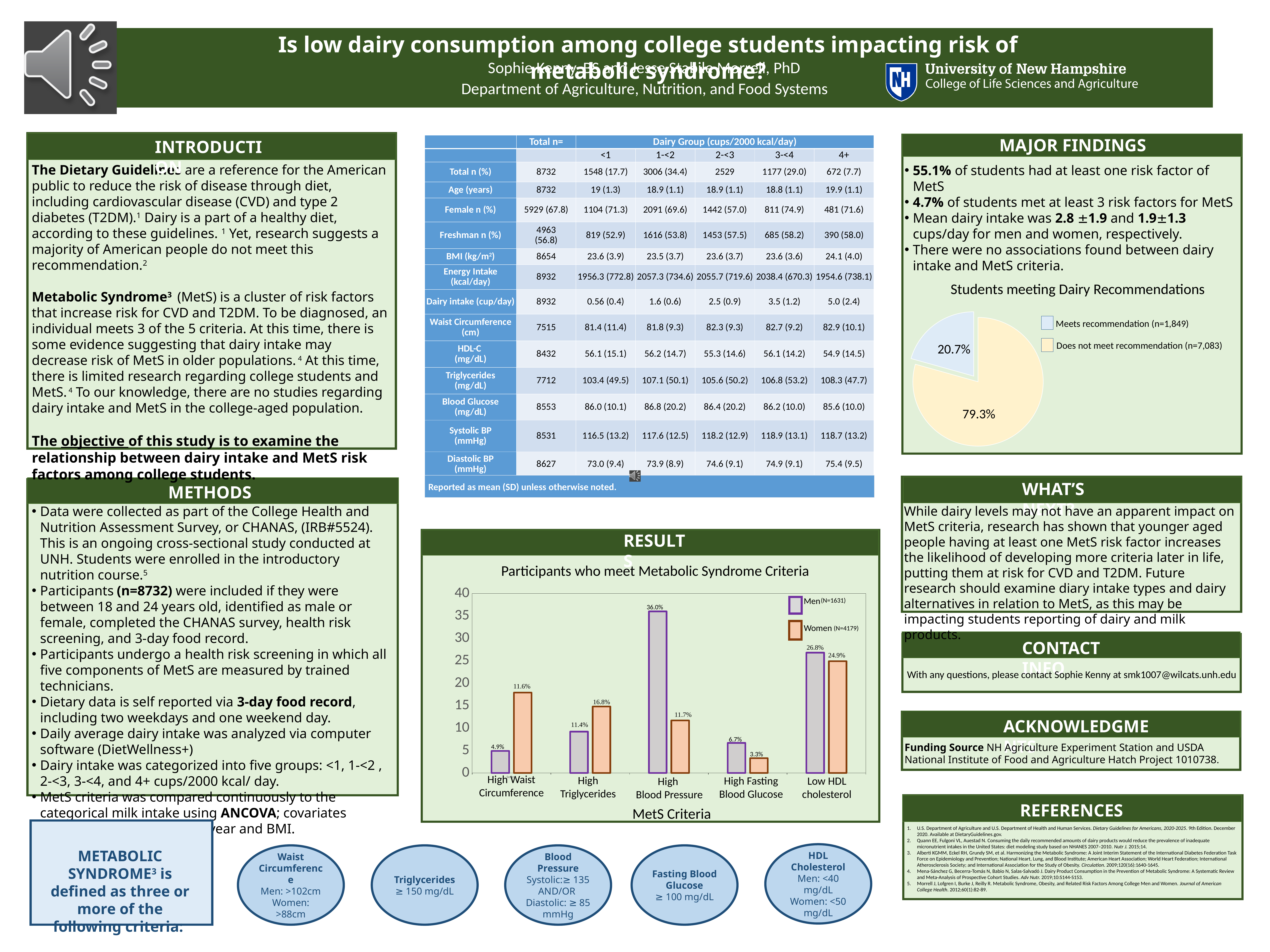
How many MetS criteria categories are shown on the x axis of the 'Participants who meet Metabolic Syndrome Criteria' chart? 5 What kind of chart is 'Participants who meet Metabolic Syndrome Criteria'? bar chart In the 'Participants who meet Metabolic Syndrome Criteria' chart, which MetS criterion has the lowest value for Women? High Fasting Blood Glucose In the 'Participants who meet Metabolic Syndrome Criteria' chart, what is the difference between the Women and Men values for High Waist Circumference? 6.7% How many series does the legend of the 'Participants who meet Metabolic Syndrome Criteria' chart list? 2 In the 'Participants who meet Metabolic Syndrome Criteria' chart, which is larger for High Fasting Blood Glucose, Men or Women? Men In the 'Participants who meet Metabolic Syndrome Criteria' chart, what is the value for Women for High Triglycerides? 16.8% In the 'Participants who meet Metabolic Syndrome Criteria' chart, which MetS criterion has the highest value for Men? High Blood Pressure In the 'Students meeting Dairy Recommendations' pie chart, what share of students does not meet the recommendation? 79.3% In the 'Participants who meet Metabolic Syndrome Criteria' chart, what is the value for Men for High Blood Pressure? 36.0% In the 'Participants who meet Metabolic Syndrome Criteria' chart, is the value for Men for Low HDL cholesterol greater or less than 25? greater What kind of chart is 'Students meeting Dairy Recommendations'? pie chart